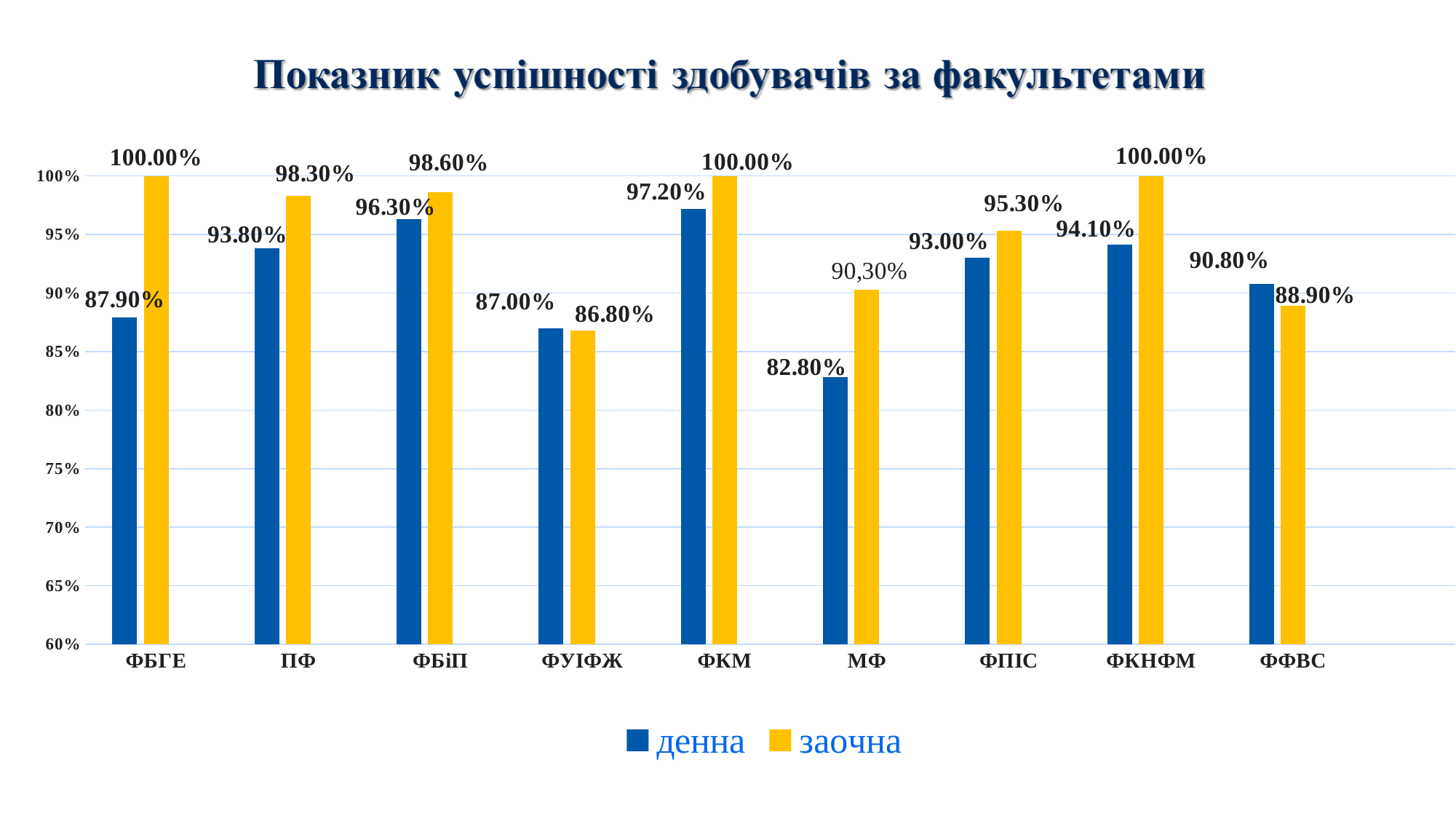
Which faculty has the lowest заочна value? ФУІФЖ Is the денна value for МФ greater or less than 85%? less What is the денна value for ФКМ? 97.20% How many faculties are shown on the x axis? 9 What is the заочна value for МФ? 90,30% What is the difference between the заочна and денна values for ФБГЕ? 12.10% Which faculty has the highest денна value? ФКМ For ФФВС, which is larger: the денна value or the заочна value? денна How many series does the legend list? 2 Which faculty has the lowest денна value? МФ What is the денна value for ФКНФМ? 94.10% What kind of chart is shown on the slide? bar chart